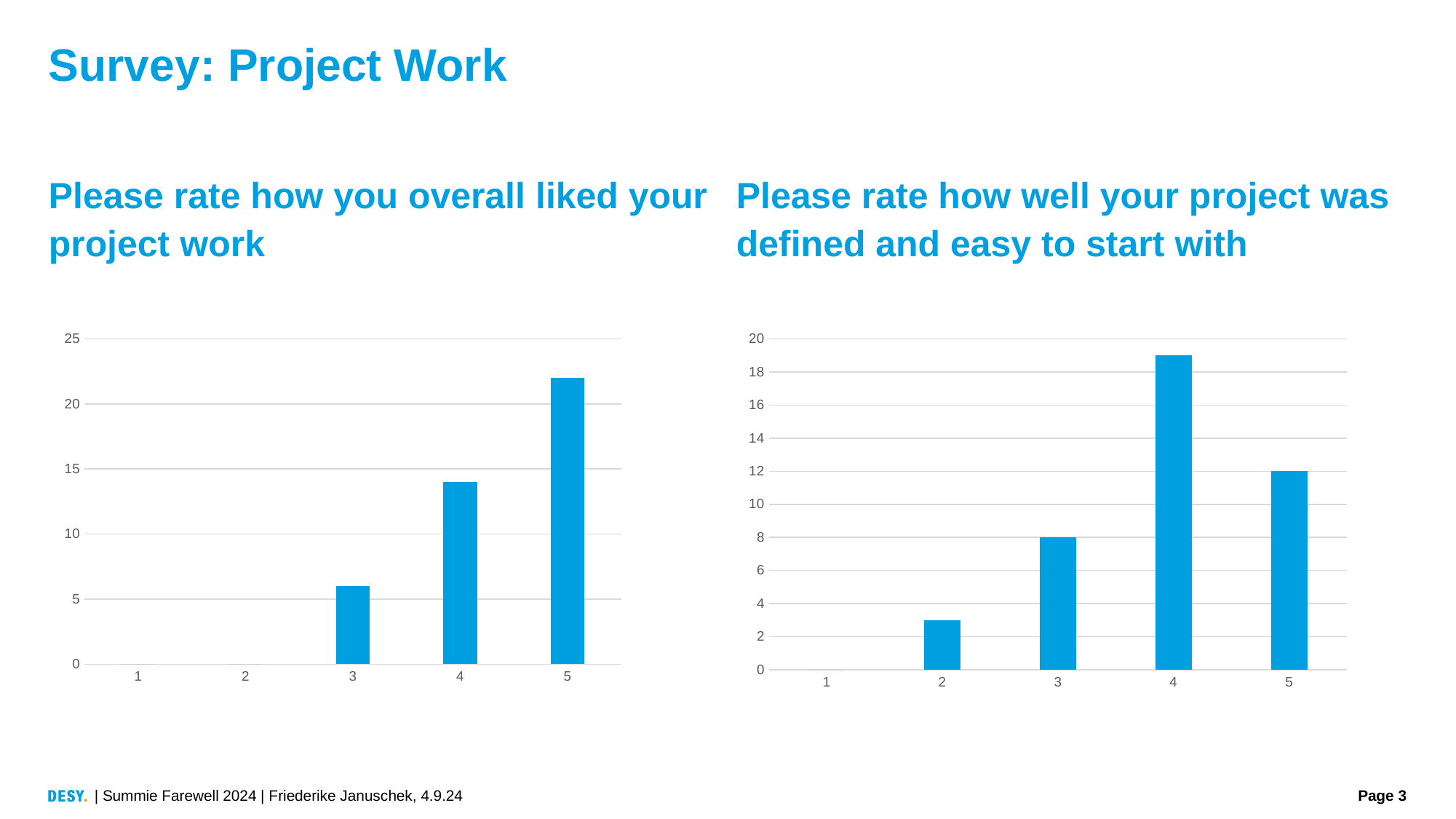
In the chart titled "Please rate how well your project was defined and easy to start with", is the value for rating 4 greater or less than 18? greater In the chart titled "Please rate how well your project was defined and easy to start with", which has the larger value, rating 2 or rating 3? 3 In the chart titled "Please rate how well your project was defined and easy to start with", what is the value for rating 5? 12 In the chart titled "Please rate how you overall liked your project work", what kind of chart is shown? bar chart In the chart titled "Please rate how you overall liked your project work", which rating has the highest value? 5 In the chart titled "Please rate how well your project was defined and easy to start with", which rating has the highest value? 4 In the chart titled "Please rate how you overall liked your project work", is the value for rating 3 greater or less than 10? less In the chart titled "Please rate how well your project was defined and easy to start with", what is the value for rating 3? 8 In the chart titled "Please rate how you overall liked your project work", how many rating categories are shown on the x axis? 5 In the chart titled "Please rate how you overall liked your project work", is the value for rating 5 greater or less than 20? greater In the chart titled "Please rate how well your project was defined and easy to start with", how much larger is the value for rating 5 than the value for rating 3? 4 In the chart titled "Please rate how you overall liked your project work", which has the larger value, rating 3 or rating 4? 4